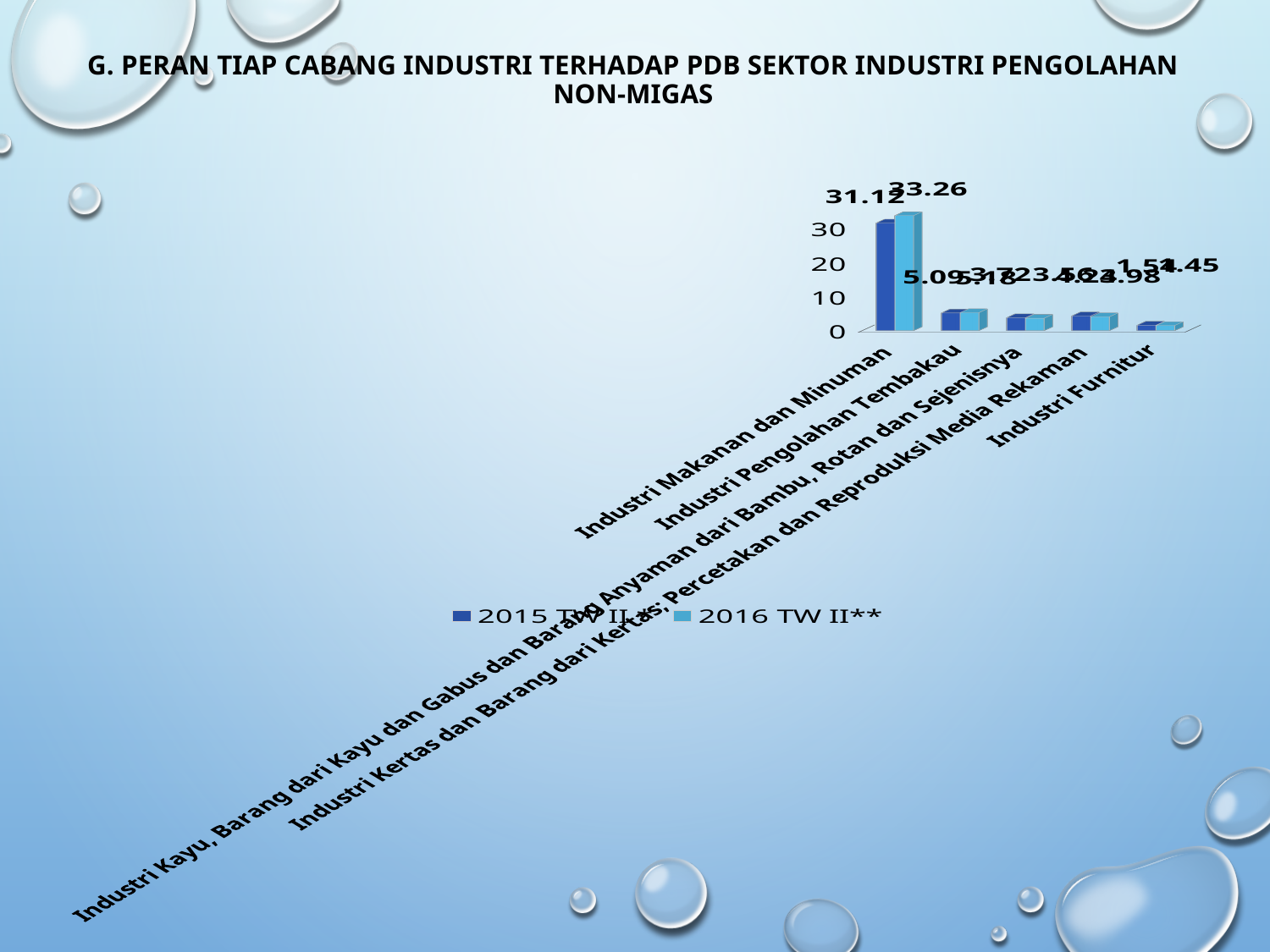
What is the 2015 TW II* value for Industri Makanan dan Minuman? 31.12 What is the 2016 TW II** value for Industri Makanan dan Minuman? 33.26 What is the 2016 TW II** value for Industri Furnitur? 1.45 Which industry has the highest values in the chart? Industri Makanan dan Minuman What is the 2016 TW II** value for Industri Pengolahan Tembakau? 5.18 What is the 2015 TW II* value for Industri Pengolahan Tembakau? 5.09 What kind of chart is shown on the slide? Bar chart What is the difference between the 2016 TW II** and 2015 TW II* values for Industri Makanan dan Minuman? 2.14 For Industri Makanan dan Minuman, which series has the larger value, 2015 TW II* or 2016 TW II**? 2016 TW II** How many series does the legend list? 2 Which industry has the lowest values in the chart? Industri Furnitur How many industry categories are shown on the x axis? 5